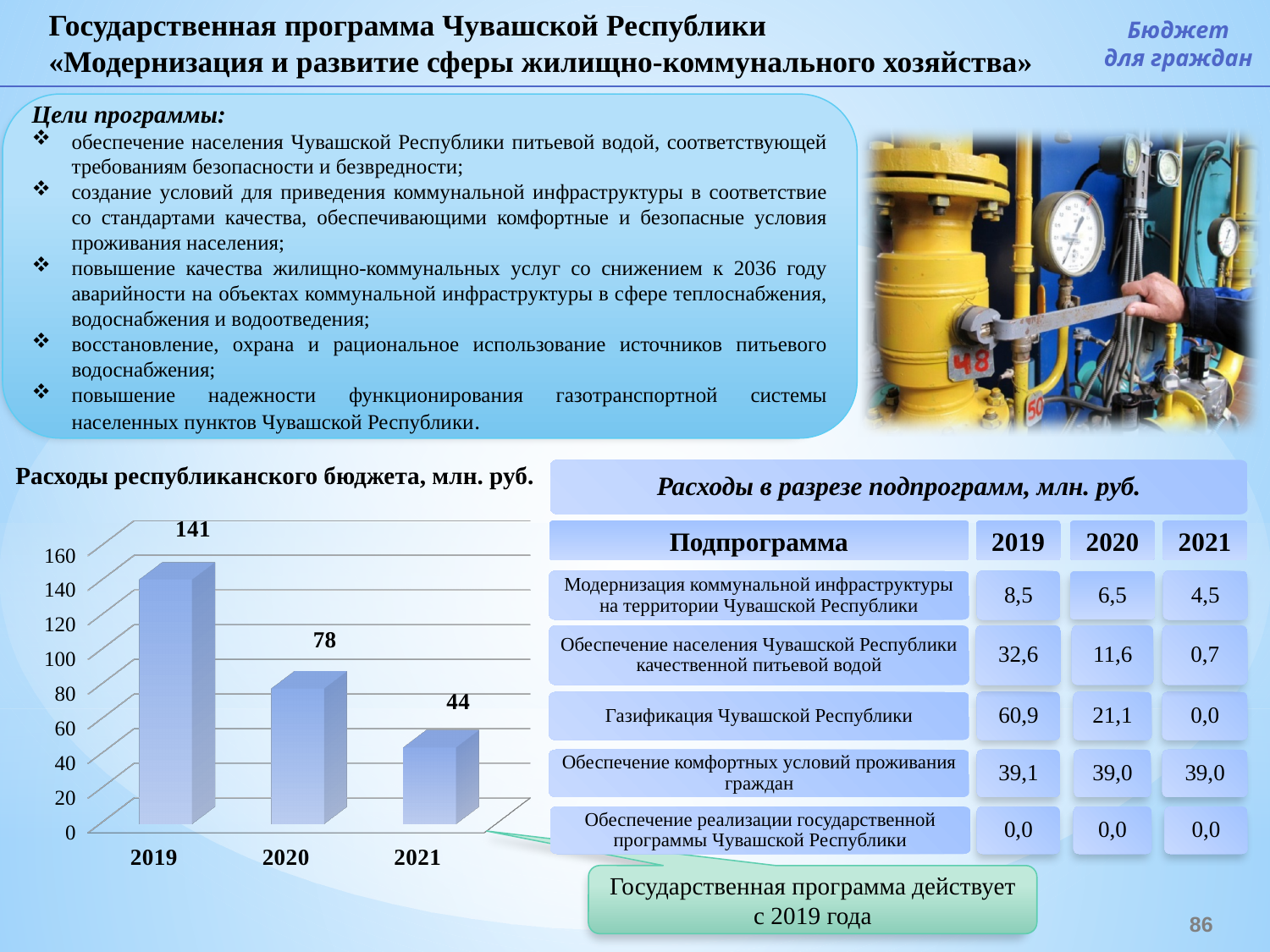
What is the difference between the values for 2020 and 2021 in the chart 'Расходы республиканского бюджета, млн. руб.'? 34 Which year has the highest value in the chart 'Расходы республиканского бюджета, млн. руб.'? 2019 What is the value for 2020 in the chart 'Расходы республиканского бюджета, млн. руб.'? 78 What is the difference between the values for 2019 and 2020 in the chart 'Расходы республиканского бюджета, млн. руб.'? 63 How many years are shown in the chart 'Расходы республиканского бюджета, млн. руб.'? 3 In the chart 'Расходы республиканского бюджета, млн. руб.', which is larger: the value for 2020 or the value for 2021? 2020 What is the value for 2019 in the chart 'Расходы республиканского бюджета, млн. руб.'? 141 Is the value for 2021 in the chart 'Расходы республиканского бюджета, млн. руб.' greater or less than 60? less Which year has the lowest value in the chart 'Расходы республиканского бюджета, млн. руб.'? 2021 Do the values in the chart 'Расходы республиканского бюджета, млн. руб.' rise or fall from 2019 to 2021? fall What kind of chart is 'Расходы республиканского бюджета, млн. руб.'? bar chart What is the value for 2021 in the chart 'Расходы республиканского бюджета, млн. руб.'? 44